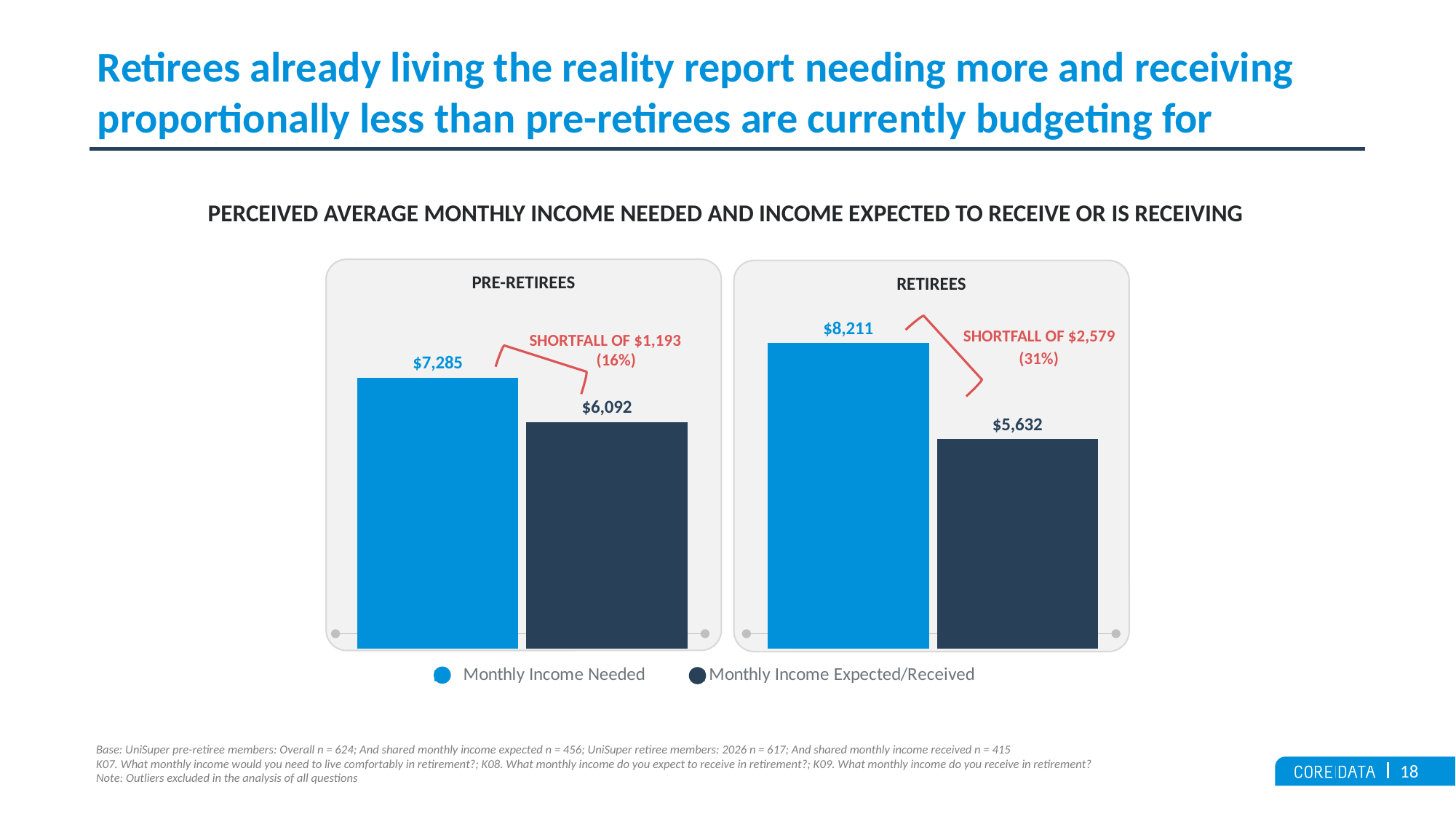
Which is larger: Monthly Income Needed for RETIREES or Monthly Income Needed for PRE-RETIREES? RETIREES What percentage shortfall is shown in the RETIREES chart? 31% In the RETIREES chart, what is the value for Monthly Income Needed? $8,211 Across both charts, which bar has the lowest value? Monthly Income Expected/Received for RETIREES Which is larger: Monthly Income Expected/Received for PRE-RETIREES or for RETIREES? PRE-RETIREES In the RETIREES chart, what is the difference between Monthly Income Needed and Monthly Income Expected/Received? $2,579 What kind of chart is shown on the slide? Bar chart In the PRE-RETIREES chart, what is the difference between Monthly Income Needed and Monthly Income Expected/Received? $1,193 In the PRE-RETIREES chart, what is the value for Monthly Income Expected/Received? $6,092 In the PRE-RETIREES chart, what is the value for Monthly Income Needed? $7,285 How many series does the legend list? 2 In the RETIREES chart, what is the value for Monthly Income Expected/Received? $5,632